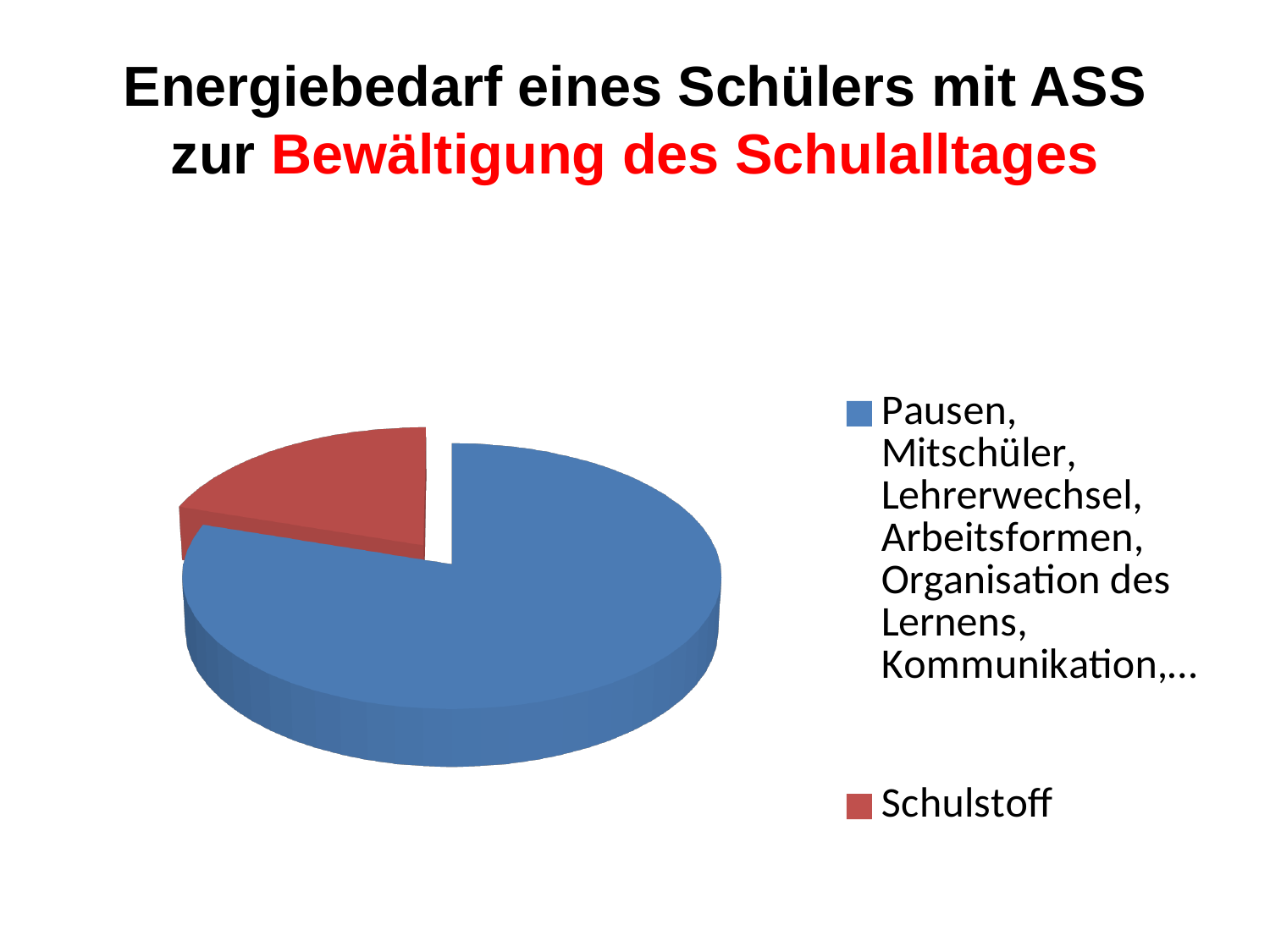
How many entries does the legend of the pie chart list? 2 How many slices does the pie chart have? 2 Which slice of the pie chart is the largest? Pausen, Mitschüler, Lehrerwechsel, Arbeitsformen, Organisation des Lernens, Kommunikation,… What colour is the Schulstoff slice in the pie chart? Red Which is larger in the pie chart: the slice for Schulstoff or the slice for Pausen, Mitschüler, Lehrerwechsel, Arbeitsformen, Organisation des Lernens, Kommunikation,…? Pausen, Mitschüler, Lehrerwechsel, Arbeitsformen, Organisation des Lernens, Kommunikation,… Is the Schulstoff slice larger or smaller than the other slice in the pie chart? Smaller Which slice of the pie chart is the smallest? Schulstoff What kind of chart is shown on the slide? Pie chart What is the title of the slide containing the pie chart? Energiebedarf eines Schülers mit ASS zur Bewältigung des Schulalltages